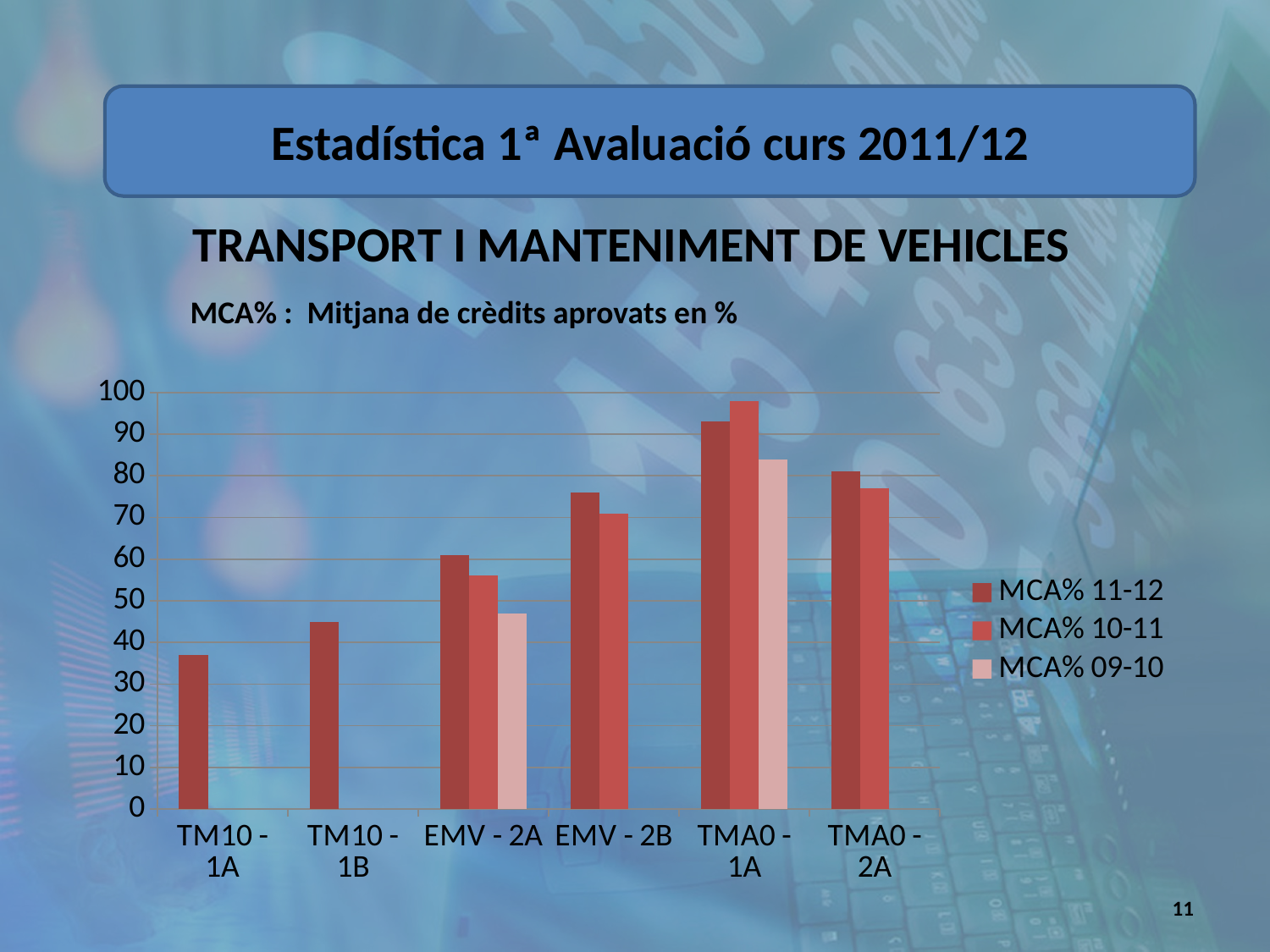
How many categories are shown on the x axis of the chart? 6 For EMV - 2A, which series has the larger value: MCA% 11-12 or MCA% 10-11? MCA% 11-12 What are the three series names listed in the chart legend? MCA% 11-12, MCA% 10-11, MCA% 09-10 What kind of chart is shown on the slide? bar chart Is the MCA% 11-12 value for EMV - 2B greater or less than 70? greater Which category has the lowest value for the MCA% 11-12 series? TM10 - 1A Which category has the highest value for the MCA% 11-12 series? TMA0 - 1A How many series does the chart legend list? 3 For TMA0 - 1A, which series has the larger value: MCA% 11-12 or MCA% 10-11? MCA% 10-11 Is the MCA% 11-12 value for TM10 - 1A greater or less than 40? less Is the MCA% 10-11 value for TMA0 - 1A greater or less than 90? greater